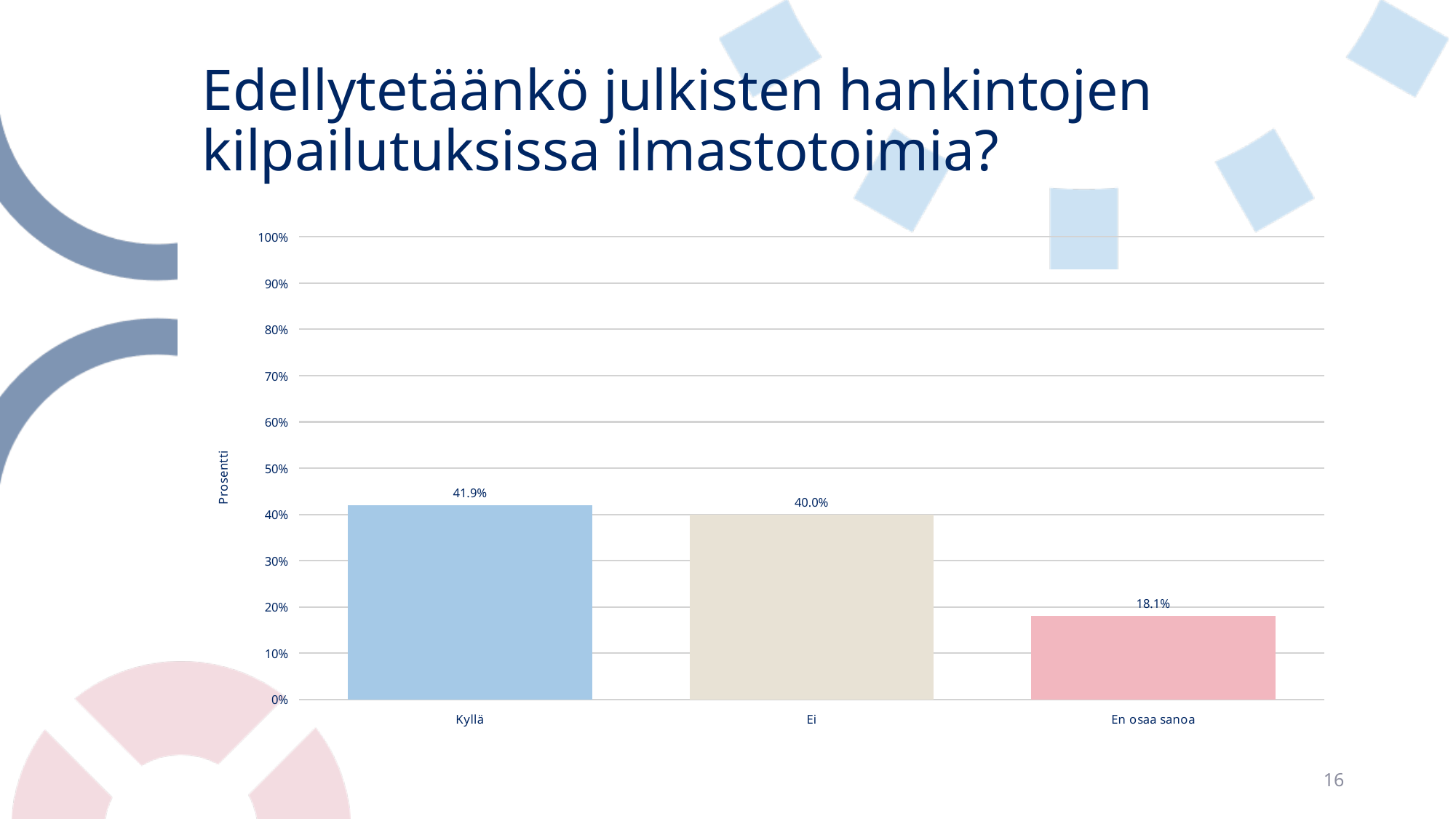
What is the difference between the values for Kyllä and Ei? 1.9% How many categories are shown on the x axis? 3 What kind of chart is shown on the slide? bar chart What is the value for En osaa sanoa? 18.1% Which category has the highest value? Kyllä Which category has the lowest value? En osaa sanoa What is the value for Kyllä? 41.9% Is the value for En osaa sanoa greater or less than 20%? less What is the difference between the values for Ei and En osaa sanoa? 21.9% What is the value for Ei? 40.0% Which is larger, the value for Ei or the value for En osaa sanoa? Ei What is the label of the vertical axis? Prosentti